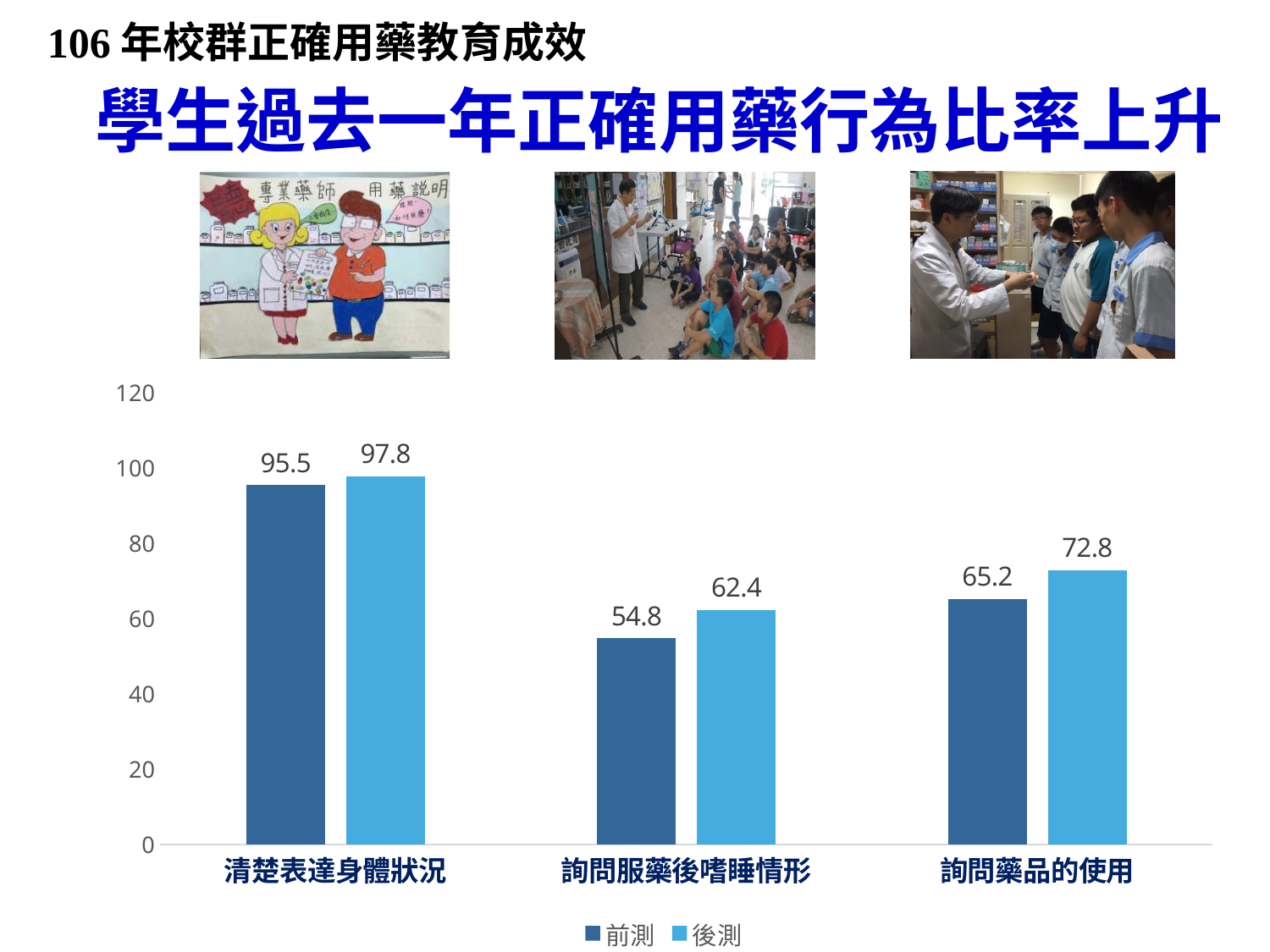
What is the 前測 value for 清楚表達身體狀況? 95.5 What is the difference between the 後測 and 前測 values for 詢問藥品的使用? 7.6 Which is larger: the 前測 value for 詢問藥品的使用 or the 後測 value for 詢問服藥後嗜睡情形? 前測 value for 詢問藥品的使用 How many series does the legend list? 2 How many categories are shown on the x axis? 3 Which category has the highest 後測 value? 清楚表達身體狀況 What is the 後測 value for 詢問藥品的使用? 72.8 What is the difference between the 後測 and 前測 values for 詢問服藥後嗜睡情形? 7.6 What kind of chart is shown on the slide? bar chart Is the 前測 value for 詢問服藥後嗜睡情形 greater or less than 60? less What is the 後測 value for 詢問服藥後嗜睡情形? 62.4 Which category has the lowest 前測 value? 詢問服藥後嗜睡情形